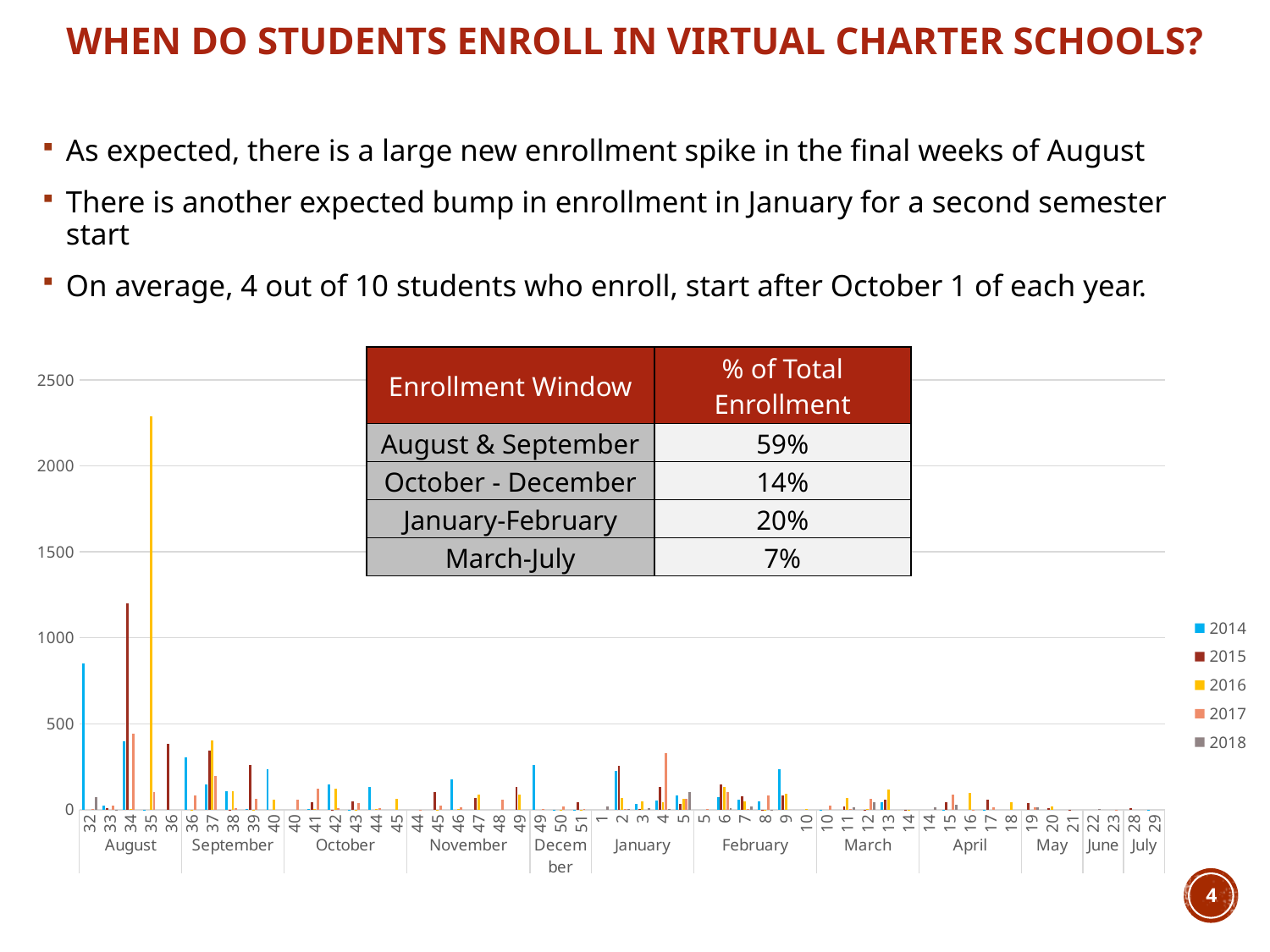
In which month does the tallest bar in the chart occur? August Is the 2014 bar for week 32 in August greater or less than 500? greater How many months are labelled along the x axis of the chart? 12 Is the tallest 2015 bar (week 34, August) greater or less than 1000? greater Is the 2014 bar for week 32 in August greater or less than 1000? less How many series does the chart legend list? 5 Which series has the tallest bar in the chart? 2016 What kind of chart is shown on the slide? bar chart Which is larger: the 2014 bar for week 32 in August or the 2015 bar for week 34 in August? 2015 bar for week 34 Which years are listed in the chart legend? 2014, 2015, 2016, 2017, 2018 Do enrollment values generally rise or fall along the x axis from August to July? fall